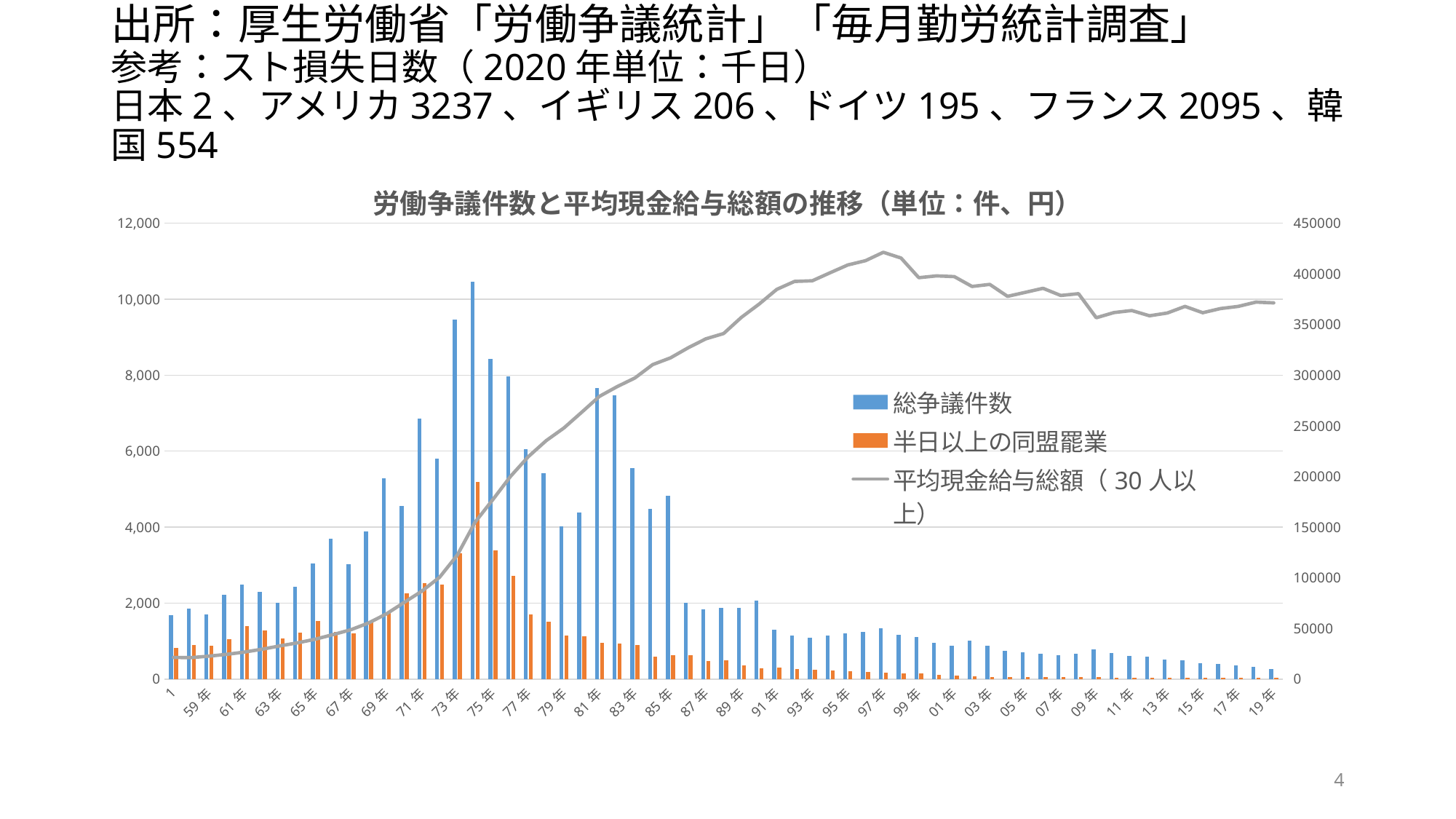
Is the value of 平均現金給与総額（30人以上） for 59年 greater or less than 50000? less Is the value of 総争議件数 for 73年 greater or less than 8,000? greater How many series does the chart legend list? 3 Is the value of 平均現金給与総額（30人以上） for 97年 greater or less than 400000? greater At 75年, which series has the larger value, 総争議件数 or 半日以上の同盟罷業? 総争議件数 What kind of chart is shown on the slide? A combined bar and line chart Which series is drawn as a gray line? 平均現金給与総額（30人以上） Do the 総争議件数 bars generally rise or fall from 85年 to 19年? fall Does the 平均現金給与総額（30人以上） line generally rise or fall from 59年 to 97年? rise Which is larger, the 総争議件数 value for 73年 or for 19年? 73年 What is the title of the chart? 労働争議件数と平均現金給与総額の推移（単位：件、円）